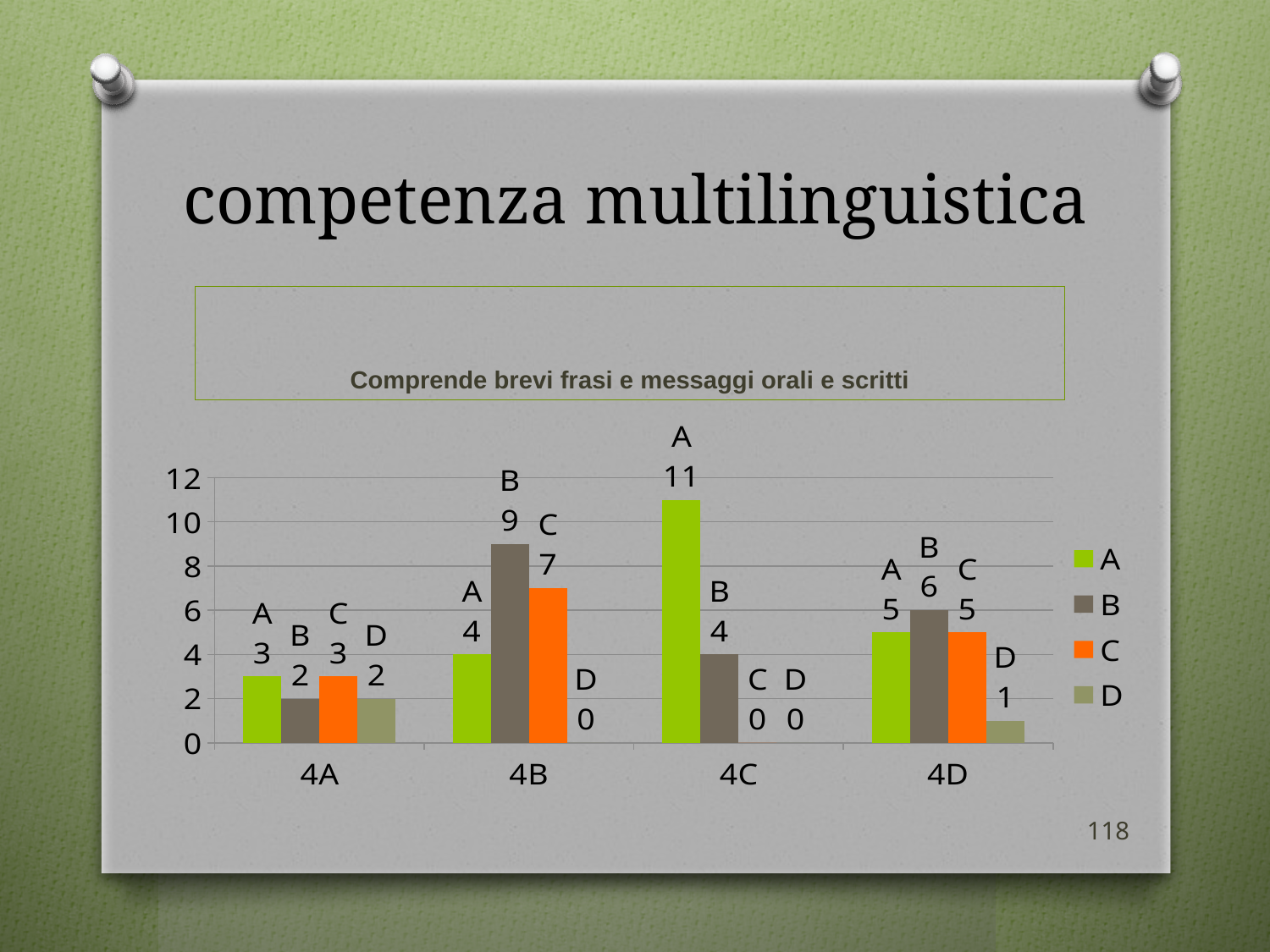
How many series does the legend list? 4 For class 4D, which is larger: series B or series C? B What is the title of the chart? Comprende brevi frasi e messaggi orali e scritti What is the value of series B for class 4B? 9 What is the difference between series B and series A for class 4B? 5 How many classes are shown on the x axis? 4 What is the value of series D for class 4D? 1 Which class has the lowest value for series B? 4A What kind of chart is shown on the slide? bar chart What is the value of series A for class 4C? 11 Which class has the highest value for series A? 4C What is the value of series C for class 4A? 3